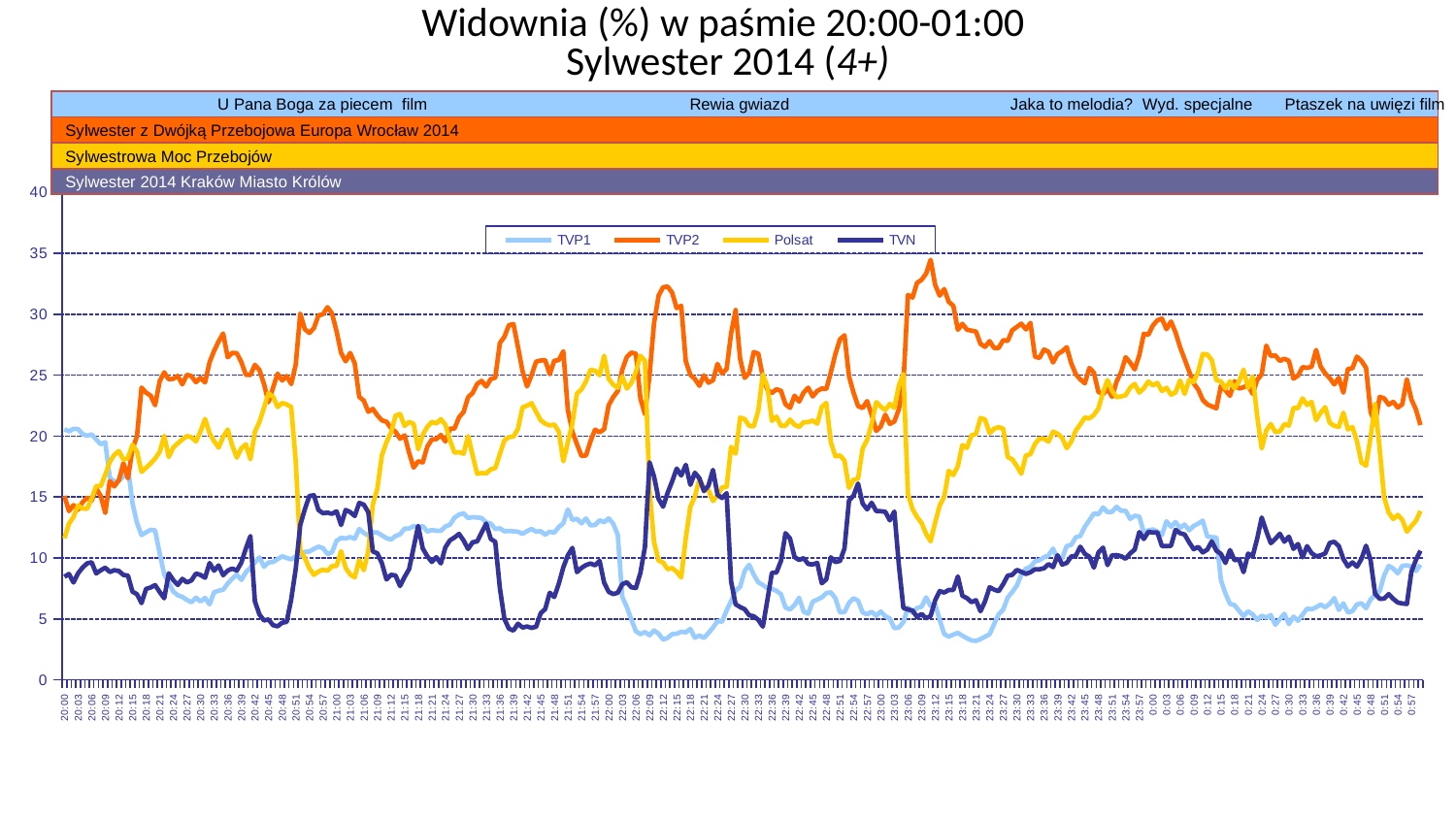
Is the peak value for TVP2 around 23:12 greater or less than 30? greater How many series does the legend list? 4 At around 23:12, which series has the higher value, TVP2 or Polsat? TVP2 Which series has the lowest value at around 23:21? TVP1 Is the value for TVP2 around 20:54 greater or less than 25? greater Is the value for Polsat around 23:12 greater or less than 15? less What kind of chart is shown on the slide? line chart Which series reaches the highest value on the chart? TVP2 Which series are listed in the legend? TVP1, TVP2, Polsat, TVN What is the title of the chart? Widownia (%) w paśmie 20:00-01:00 Sylwester 2014 (4+)